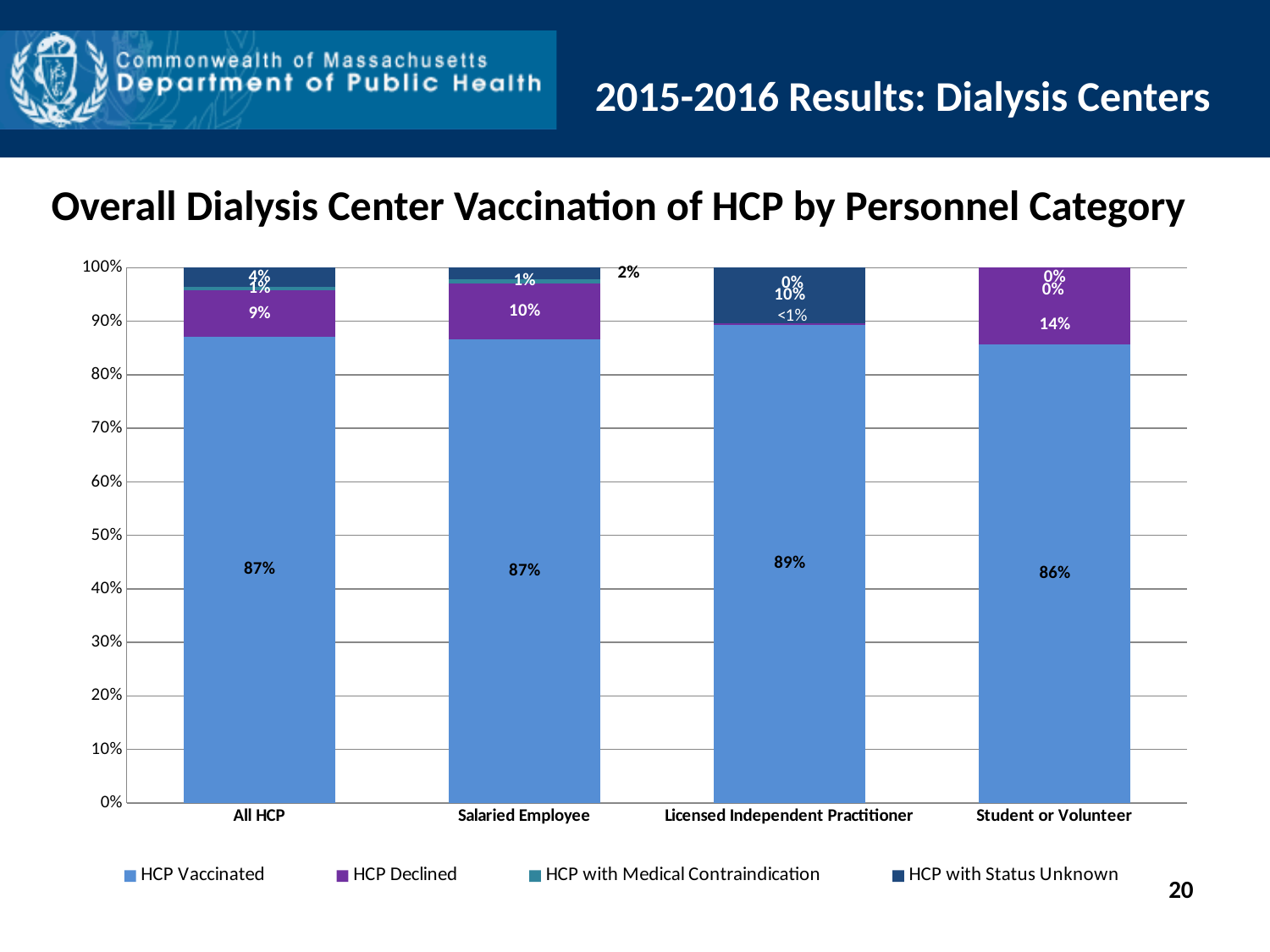
Which personnel category has the highest HCP Declined percentage? Student or Volunteer What kind of chart is shown on the slide? Stacked bar chart What is the difference between the HCP Declined values for Student or Volunteer and All HCP? 5% What is the HCP Declined value for Student or Volunteer? 14% How many series does the legend list? 4 What is the HCP Vaccinated value for Student or Volunteer? 86% How many personnel categories are shown on the x axis? 4 Which personnel category has the lowest HCP Vaccinated percentage? Student or Volunteer What is the HCP Vaccinated value for Licensed Independent Practitioner? 89% What is the HCP Declined value for All HCP? 9% What is the HCP Declined value for Salaried Employee? 10% Which personnel category has the highest HCP Vaccinated percentage? Licensed Independent Practitioner